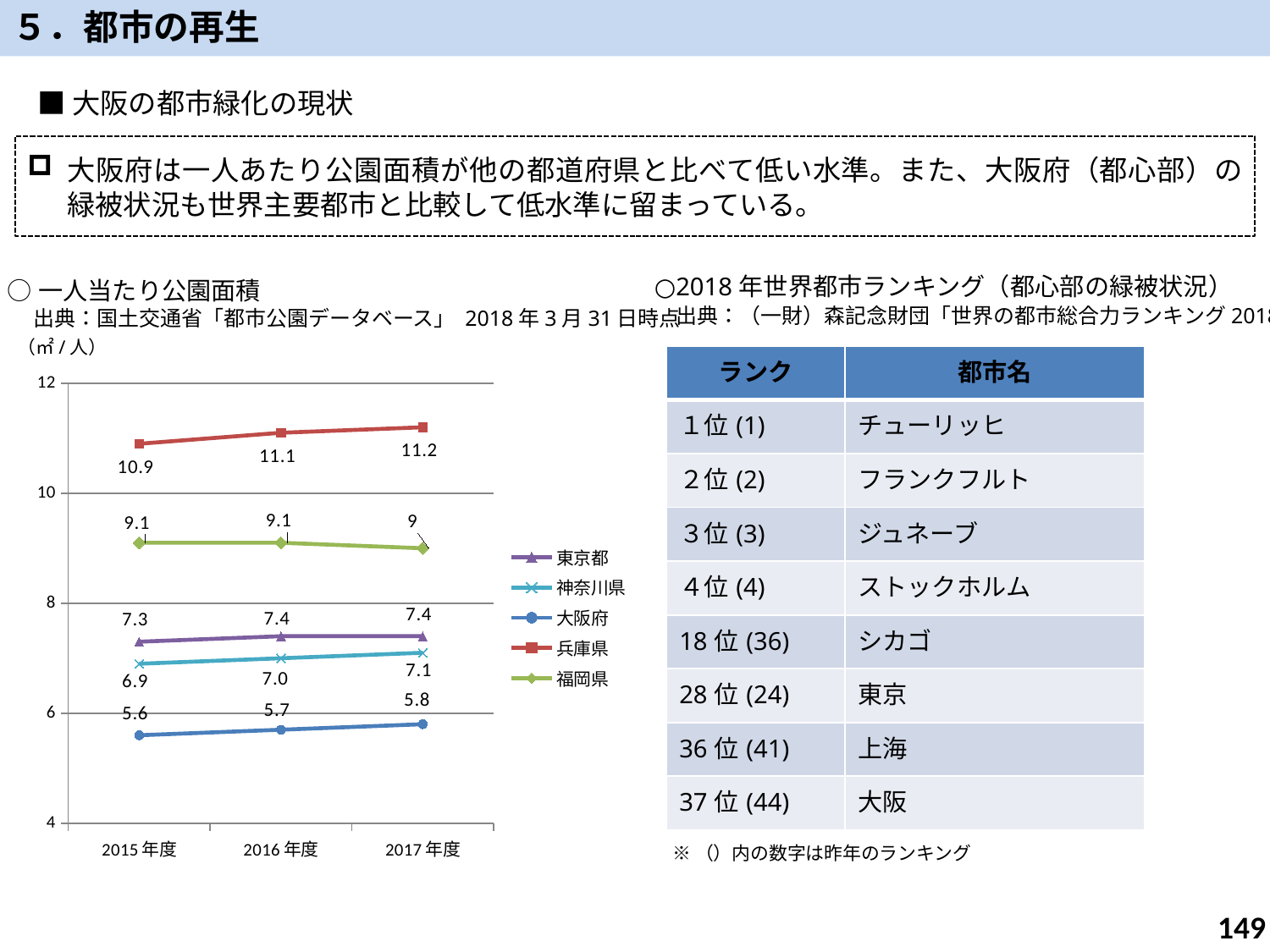
What is the difference between 兵庫県 and 大阪府 in 2017年度? 5.4 What is the value for 大阪府 in 2015年度? 5.6 How many fiscal years are plotted on the x axis of the line chart? 3 What is the value for 福岡県 in 2017年度? 9 What type of chart is shown on the slide? line chart Does the value for 大阪府 rise or fall from 2015年度 to 2017年度? rise Which prefecture has the highest value in 2017年度? 兵庫県 What is the value for 神奈川県 in 2016年度? 7.0 Which prefecture has the lowest value in 2015年度? 大阪府 Which is larger in 2016年度, 東京都 or 神奈川県? 東京都 What is the value for 兵庫県 in 2017年度? 11.2 How many series does the legend of the line chart list? 5